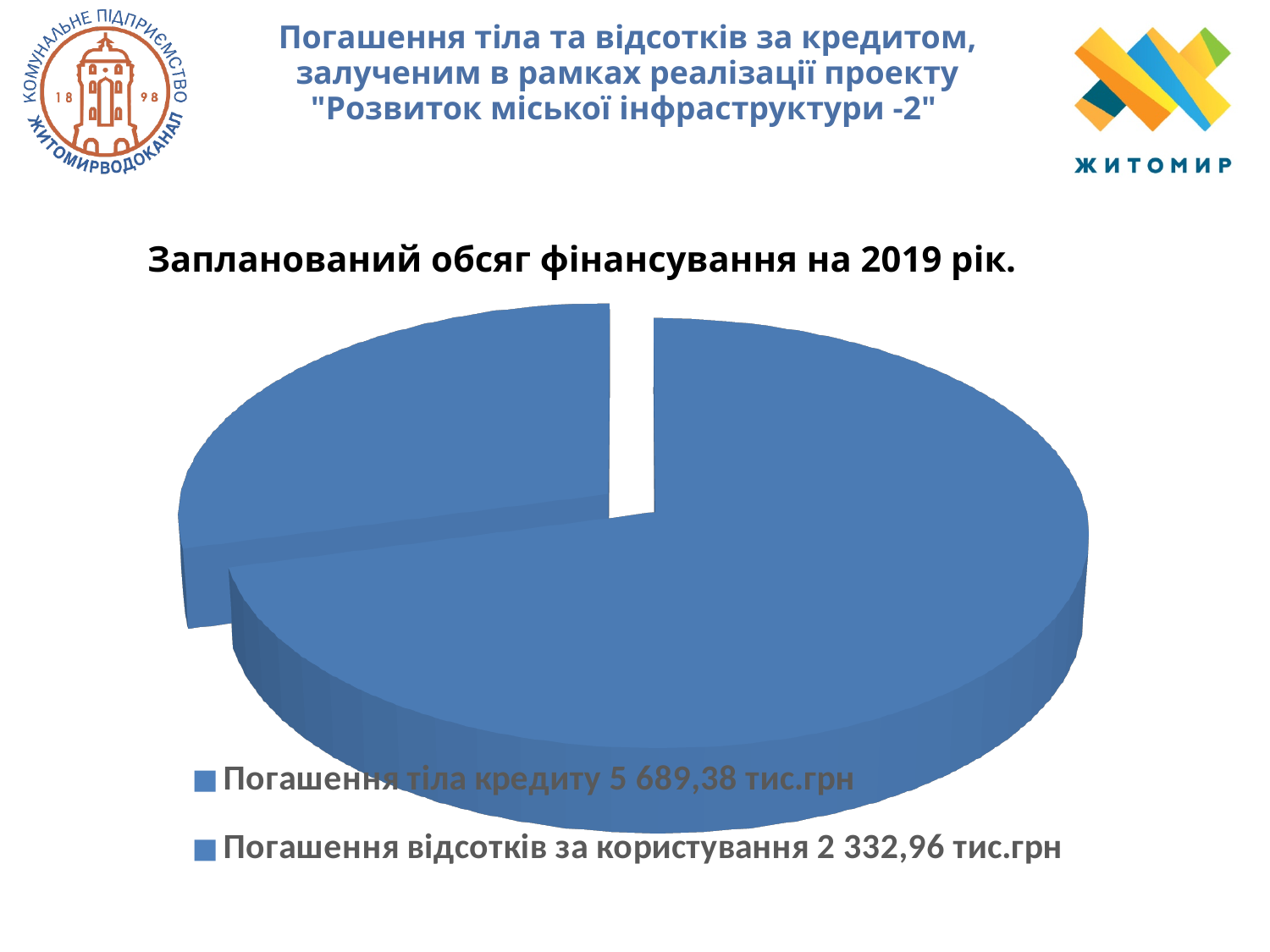
What is the title of the chart? Запланований обсяг фінансування на 2019 рік. What colour are the slices of the pie chart? Blue Which is larger: "Погашення тіла кредиту" or "Погашення відсотків за користування"? Погашення тіла кредиту How many slices does the pie chart have? 2 Which category has the smallest slice of the pie? Погашення відсотків за користування What kind of chart is shown on the slide? Pie chart How many entries does the legend list? 2 What value is shown for "Погашення відсотків за користування"? 2 332,96 тис.грн What value is shown for "Погашення тіла кредиту"? 5 689,38 тис.грн Which category has the largest slice of the pie? Погашення тіла кредиту What is the difference between the value for "Погашення тіла кредиту" and the value for "Погашення відсотків за користування"? 3 356,42 тис.грн